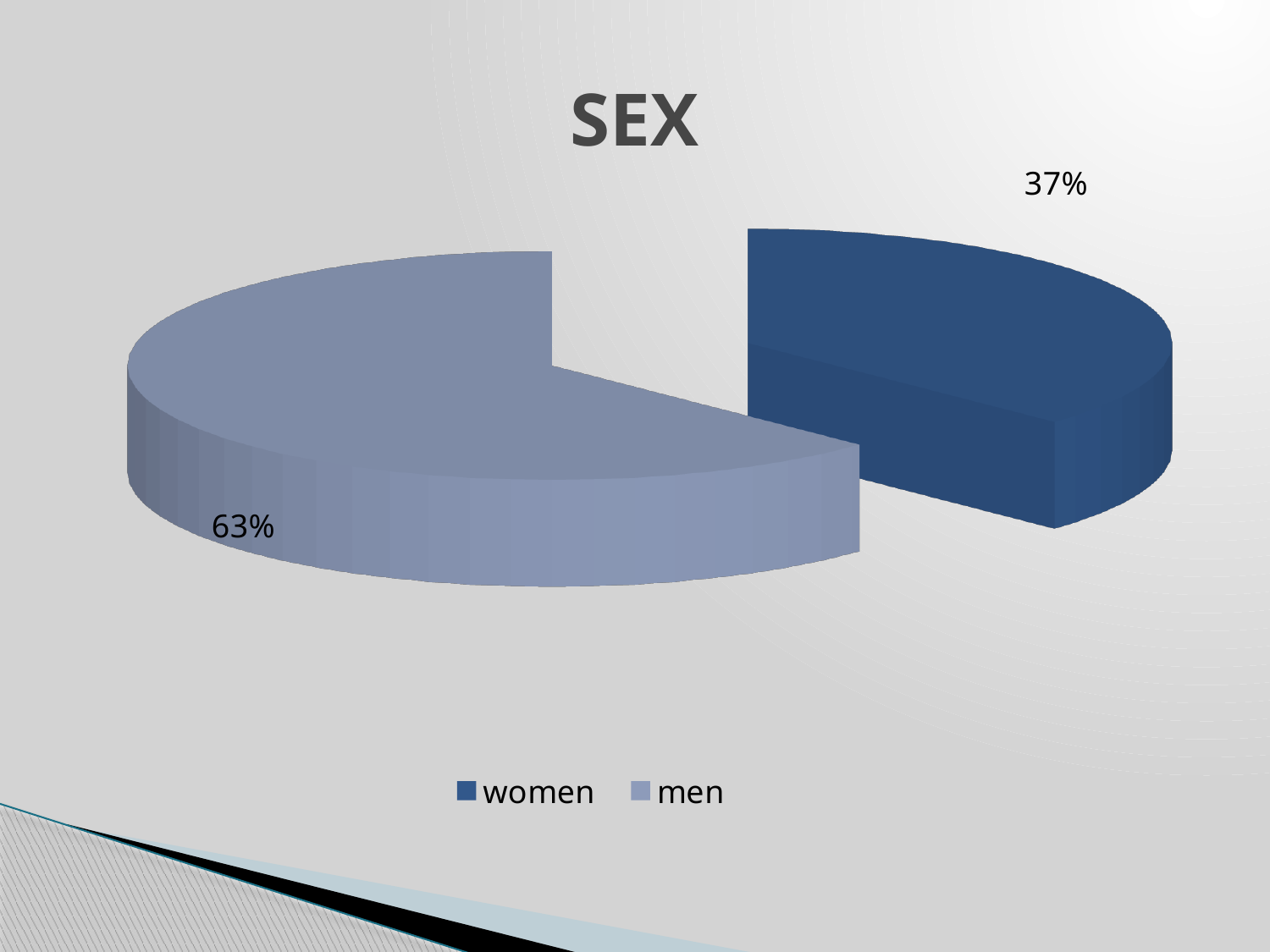
How many entries does the legend list? 2 Which legend entry is shown in the darker blue colour? women What share of the pie is women? 37% Which category has the largest share of the pie? men What is the title of the chart? SEX What is the difference in percentage points between the men and women shares? 26 What share of the pie is men? 63% Which category has the smallest share of the pie? women Which is larger, the share for women or the share for men? men How many slices does the pie chart have? 2 What kind of chart is shown on the slide? pie chart